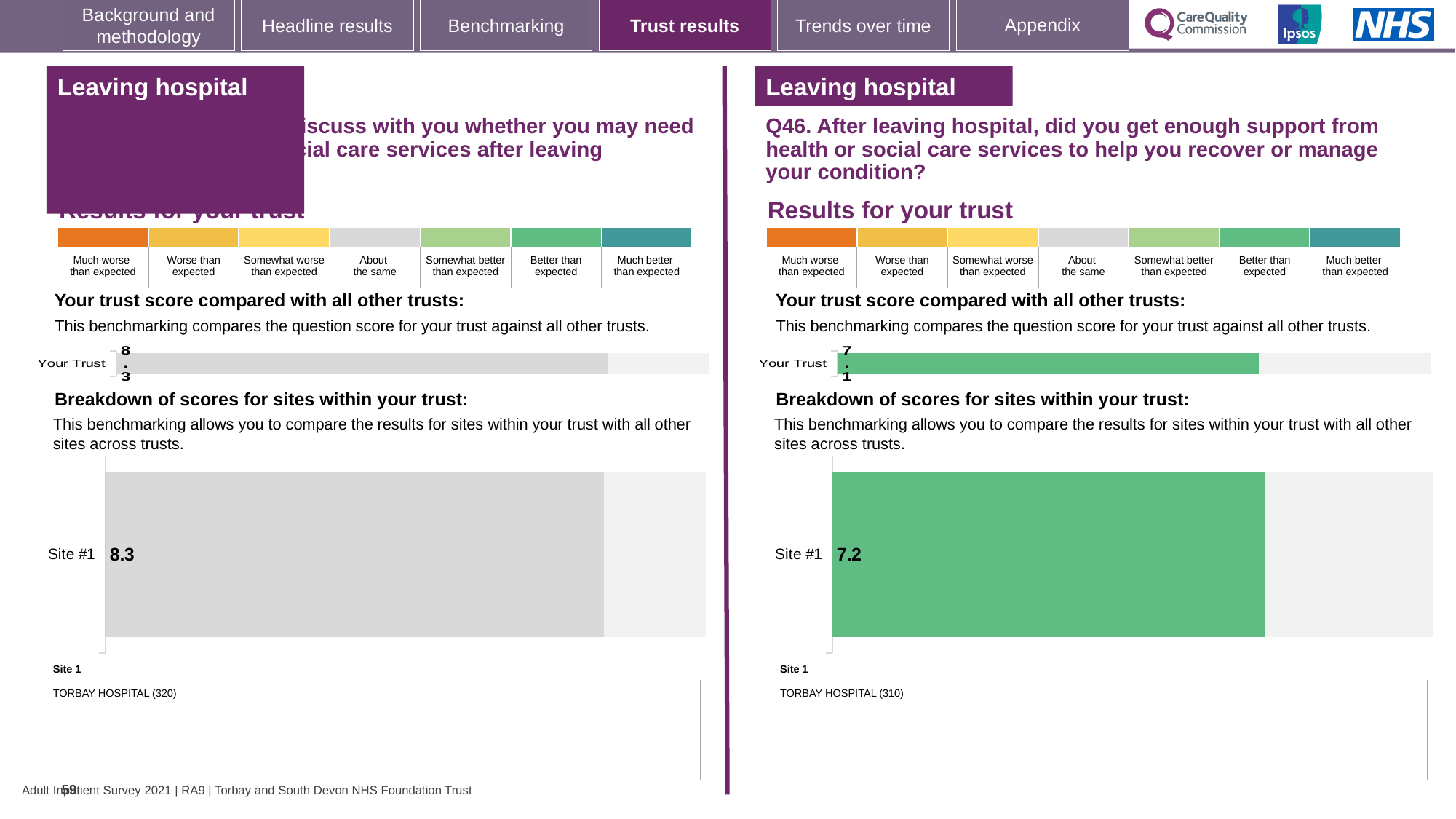
On the right-hand (Q46) breakdown chart, what colour is the Site #1 bar? Green On the left-hand breakdown chart, what colour is the Site #1 bar? Grey On the left-hand 'Breakdown of scores for sites within your trust' chart, what is the score for Site #1? 8.3 Which is larger: the Site #1 score on the left-hand breakdown chart or the Site #1 score on the right-hand (Q46) breakdown chart? Left-hand chart (8.3) What type of chart is used to show the Site #1 score on the left-hand breakdown chart? Bar chart What is the difference between the Site #1 score on the left-hand breakdown chart (8.3) and the Site #1 score on the right-hand (Q46) breakdown chart (7.2)? 1.1 On the right-hand (Q46) side, what is the difference between the Site #1 score (7.2) and the Your Trust score (7.1)? 0.1 On the left-hand 'Your trust score compared with all other trusts' chart, what is the score for Your Trust? 8.3 On the right-hand (Q46) 'Breakdown of scores for sites within your trust' chart, what is the score for Site #1? 7.2 How many sites are shown on the right-hand (Q46) 'Breakdown of scores for sites within your trust' chart? 1 Which site name is listed as Site 1 beneath the right-hand (Q46) breakdown chart? TORBAY HOSPITAL (310) On the right-hand (Q46) 'Your trust score compared with all other trusts' chart, what is the score for Your Trust? 7.1